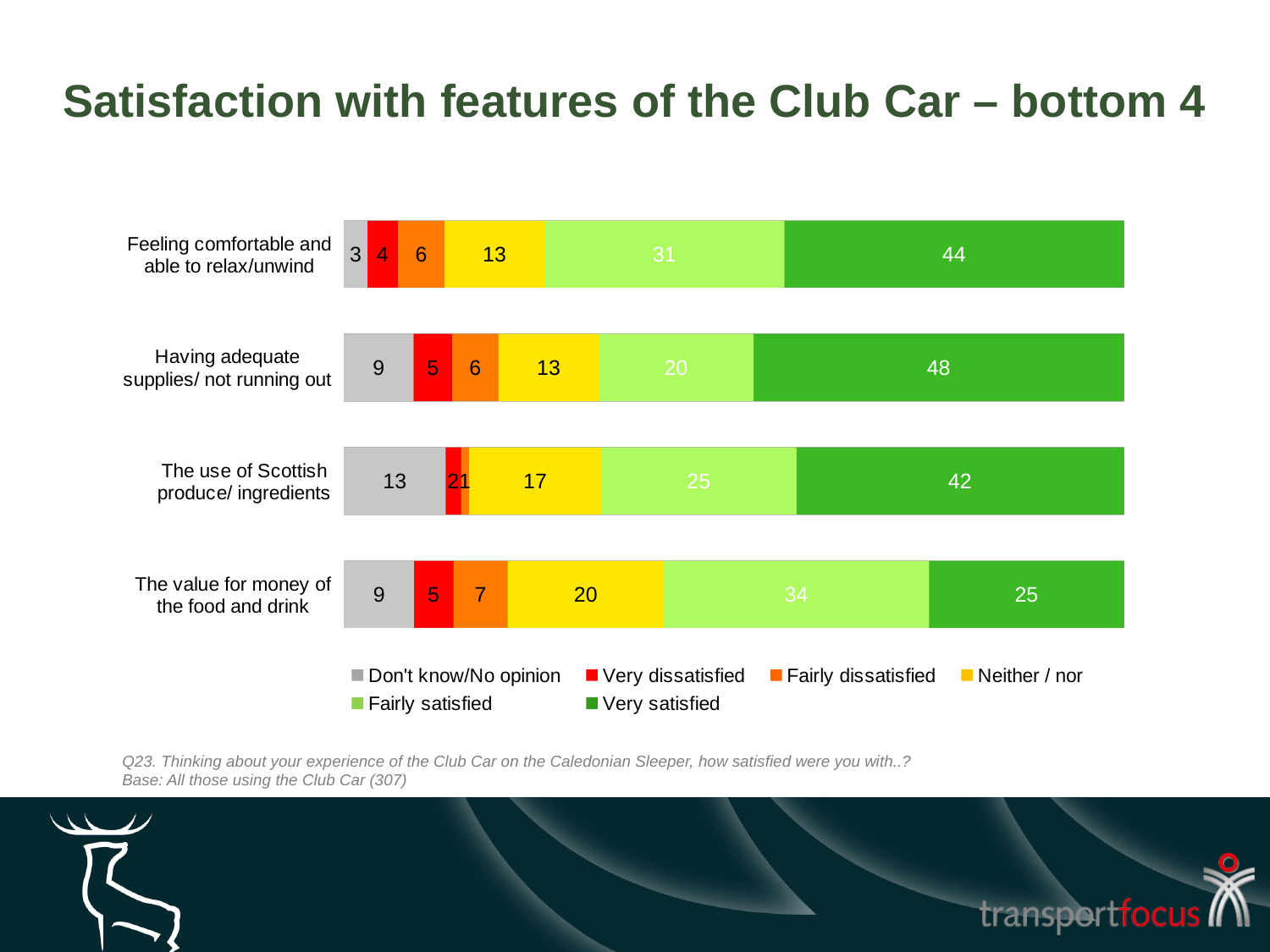
How many series does the legend list? 6 What is the Fairly satisfied value for 'The value for money of the food and drink'? 34 What is the Neither / nor value for 'Feeling comfortable and able to relax/unwind'? 13 What kind of chart is shown on the slide? Stacked bar chart Which is larger: the Fairly satisfied value for 'Feeling comfortable and able to relax/unwind' or for 'Having adequate supplies/ not running out'? Feeling comfortable and able to relax/unwind What is the Very satisfied value for 'Having adequate supplies/ not running out'? 48 What is the Don't know/No opinion value for 'The use of Scottish produce/ ingredients'? 13 Which feature has the lowest Very satisfied value? The value for money of the food and drink How many features (categories) are plotted on the chart? 4 Which feature has the highest Very satisfied value? Having adequate supplies/ not running out What is the difference between the Very satisfied values for 'Having adequate supplies/ not running out' and 'The value for money of the food and drink'? 23 What is the title of the chart on the slide? Satisfaction with features of the Club Car – bottom 4